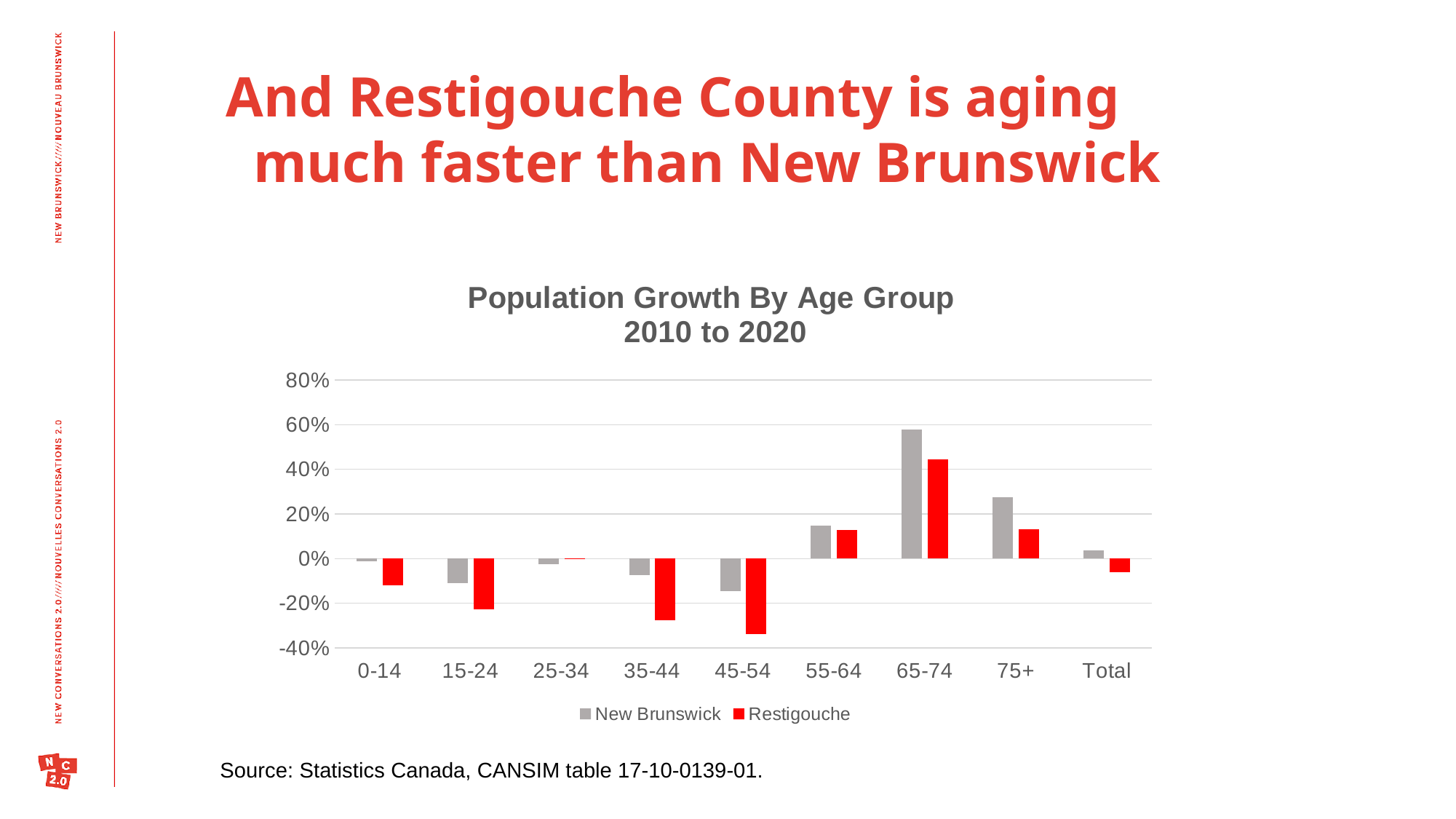
What kind of chart is shown on the slide? bar chart For the 75+ age group, which series has the larger value, New Brunswick or Restigouche? New Brunswick Is the Restigouche value for 45-54 greater or less than -20%? less For the 65-74 age group, which series has the larger value, New Brunswick or Restigouche? New Brunswick Which category has the highest value for New Brunswick? 65-74 What is the title of the chart? Population Growth By Age Group 2010 to 2020 How many series does the legend list? 2 Which category has the highest value for Restigouche? 65-74 Which category has the lowest value for New Brunswick? 45-54 Is the New Brunswick value for 65-74 greater or less than 40%? greater How many age-group categories (including Total) are shown on the x axis? 9 Which category has the lowest value for Restigouche? 45-54